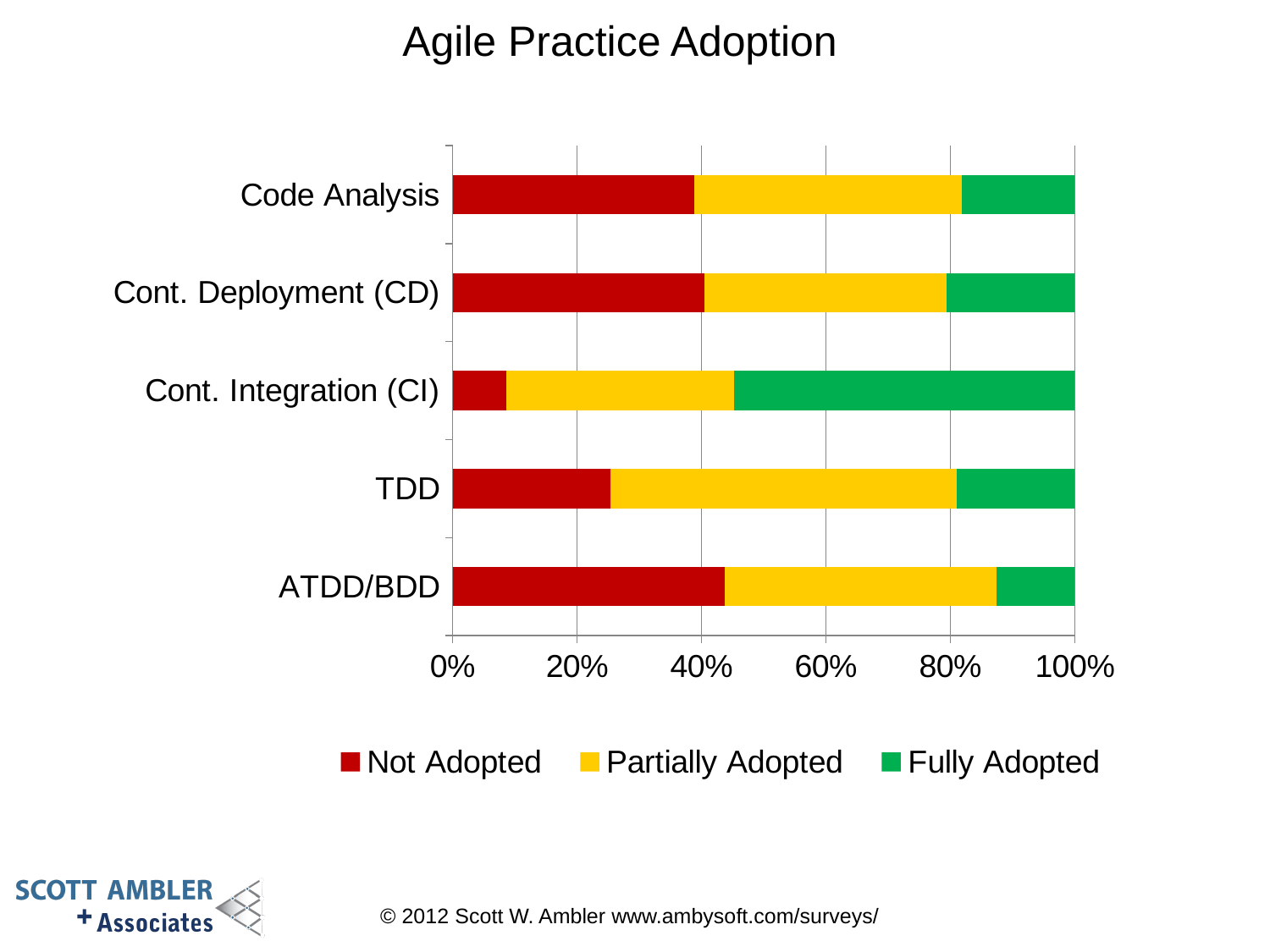
Which practice has the smallest Not Adopted share? Cont. Integration (CI) What is the total of the stacked bar for TDD? 100% What is the title of the chart? Agile Practice Adoption Which practice has the smallest Fully Adopted share? ATDD/BDD What kind of chart is shown on the slide? Stacked bar chart How many practices are listed on the chart? 5 Which practice has the largest Fully Adopted share? Cont. Integration (CI) Is the Not Adopted value for Cont. Integration (CI) greater or less than 20%? less Is the Not Adopted value for TDD greater or less than 20%? greater Which has the larger Not Adopted share, TDD or ATDD/BDD? ATDD/BDD How many series does the legend list? 3 Is the Not Adopted value for ATDD/BDD greater or less than 40%? greater